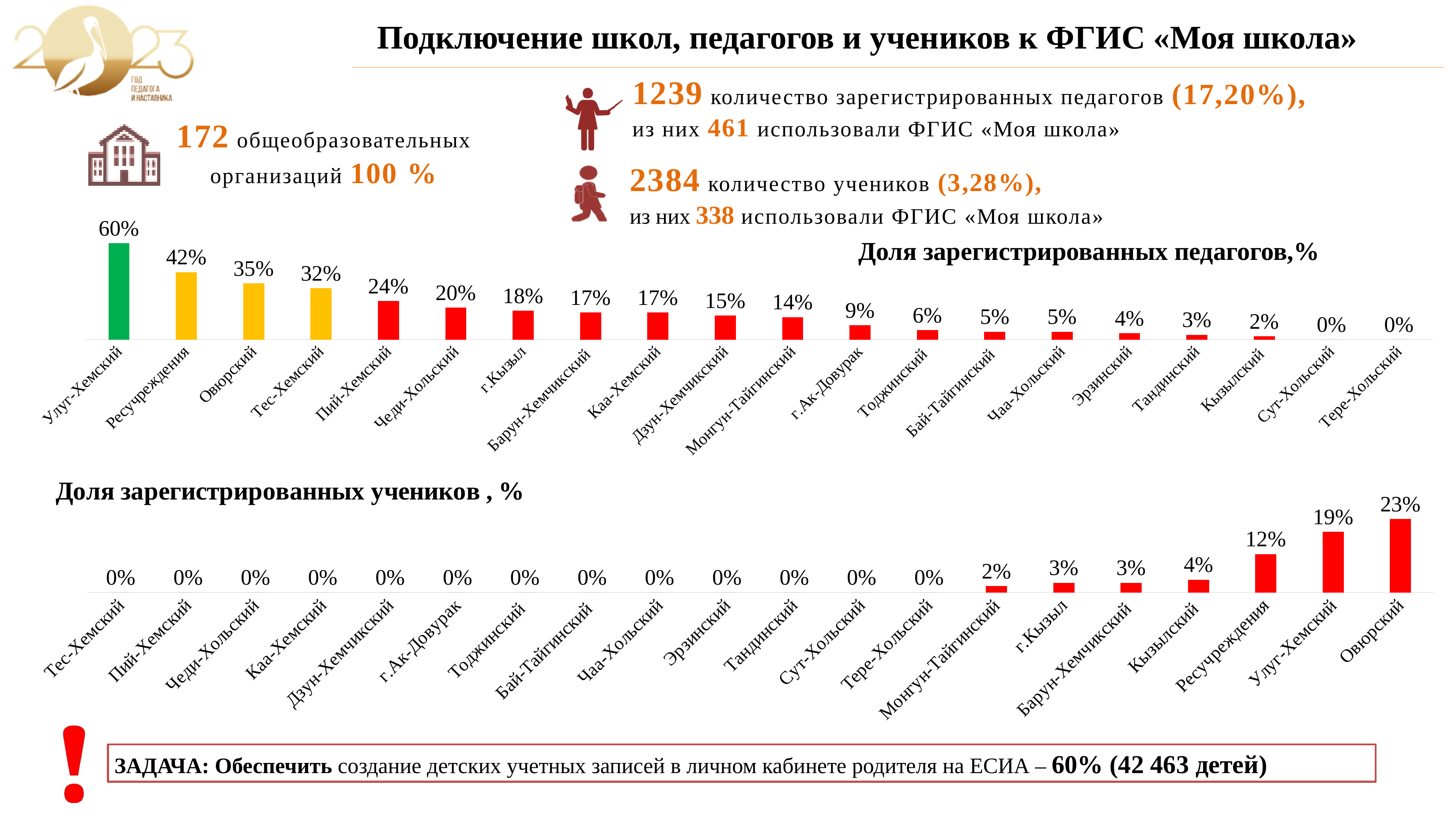
In the chart 'Доля зарегистрированных педагогов,%', what is the difference between Ресучреждения and Овюрский? 7% How many categories are shown in the chart 'Доля зарегистрированных педагогов,%'? 20 In the chart 'Доля зарегистрированных педагогов,%', what is the value for Улуг-Хемский? 60% In the chart 'Доля зарегистрированных педагогов,%', what colour is the bar for Улуг-Хемский? Green In the chart 'Доля зарегистрированных учеников , %', what is the difference between Овюрский and Улуг-Хемский? 4% In the chart 'Доля зарегистрированных учеников , %', which category has the highest value? Овюрский In the chart 'Доля зарегистрированных педагогов,%', which is larger: Пий-Хемский or Чеди-Хольский? Пий-Хемский In the chart 'Доля зарегистрированных учеников , %', what is the value for Овюрский? 23% In the chart 'Доля зарегистрированных учеников , %', what is the value for Ресучреждения? 12% What kind of chart is 'Доля зарегистрированных учеников , %'? Bar chart In the chart 'Доля зарегистрированных педагогов,%', what is the value for г.Кызыл? 18% In the chart 'Доля зарегистрированных педагогов,%', which category has the highest value? Улуг-Хемский